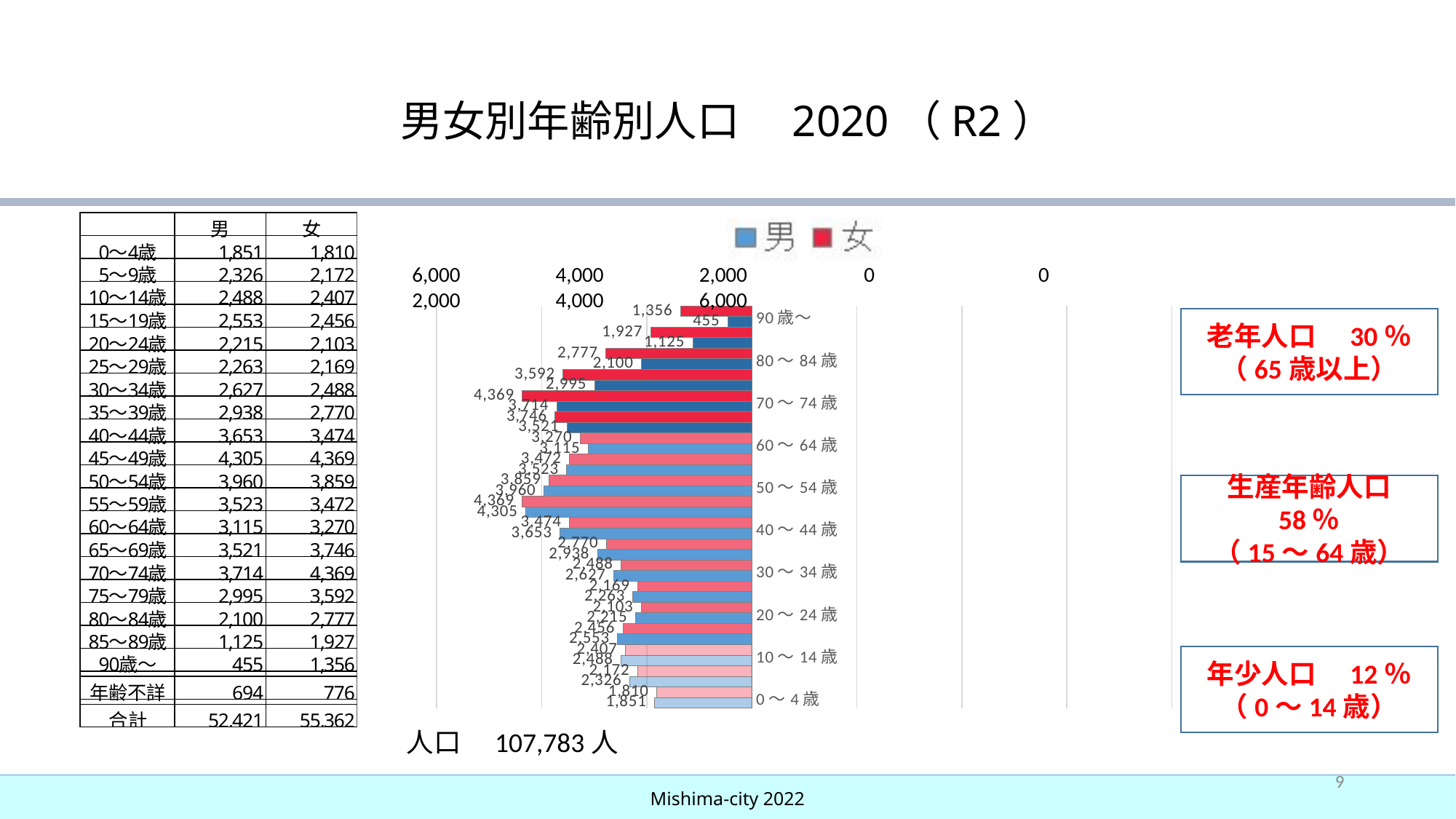
What is the 男 value for the 90歳～ age group? 455 For the 90歳～ age group, how much larger is the 女 value than the 男 value? 901 For the 35～39歳 age group, which is larger, the 男 value or the 女 value? 男 What is the 女 value for the 70～74歳 age group? 4,369 What is the 男 value for the 0～4歳 age group? 1,851 Which age group has the lowest 男 value? 90歳～ Which age group has the highest 男 value? 45～49歳 How many series does the chart legend list? 2 What are the two series named in the chart legend? 男 and 女 What kind of chart is shown on the slide? bar chart How many age groups are plotted on the chart? 19 For the 80～84歳 age group, which is larger, the 男 value or the 女 value? 女